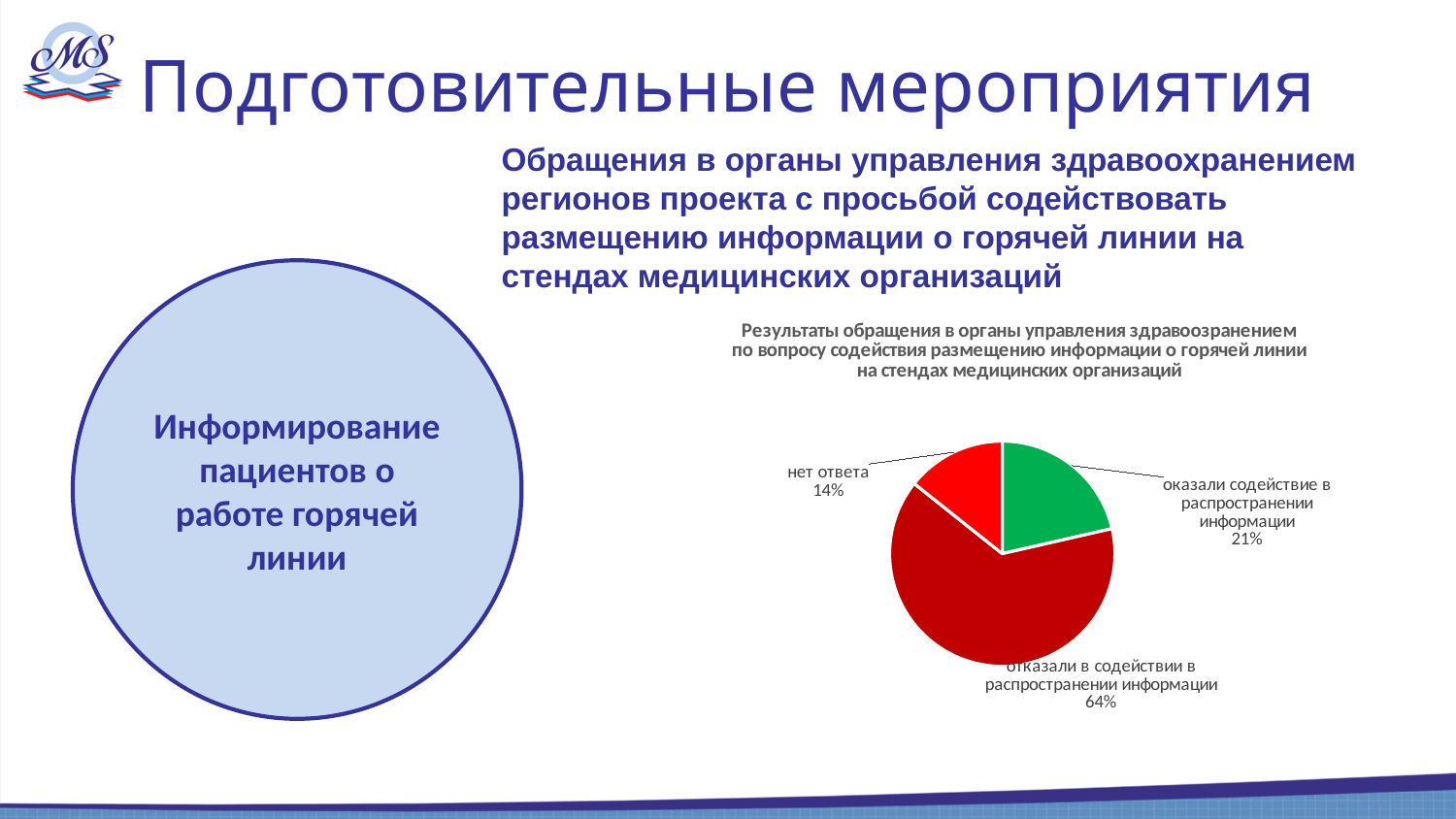
Which category has the smallest slice of the pie? нет ответа Which is larger: the share for "оказали содействие в распространении информации" or the share for "нет ответа"? оказали содействие в распространении информации What share of the pie is labelled "нет ответа"? 14% What share of the pie is labelled "оказали содействие в распространении информации"? 21% What colour is the slice for "оказали содействие в распространении информации"? green What is the difference in percentage points between "оказали содействие в распространении информации" and "нет ответа"? 7 What share of the pie is labelled "отказали в содействии в распространении информации"? 64% Which category has the largest slice of the pie? отказали в содействии в распространении информации What is the title of the pie chart? Результаты обращения в органы управления здравоозранением по вопросу содействия размещению информации о горячей линии на стендах медицинских организаций What is the difference in percentage points between "отказали в содействии в распространении информации" and "оказали содействие в распространении информации"? 43 What type of chart is shown on the slide? pie chart How many slices does the pie chart have? 3